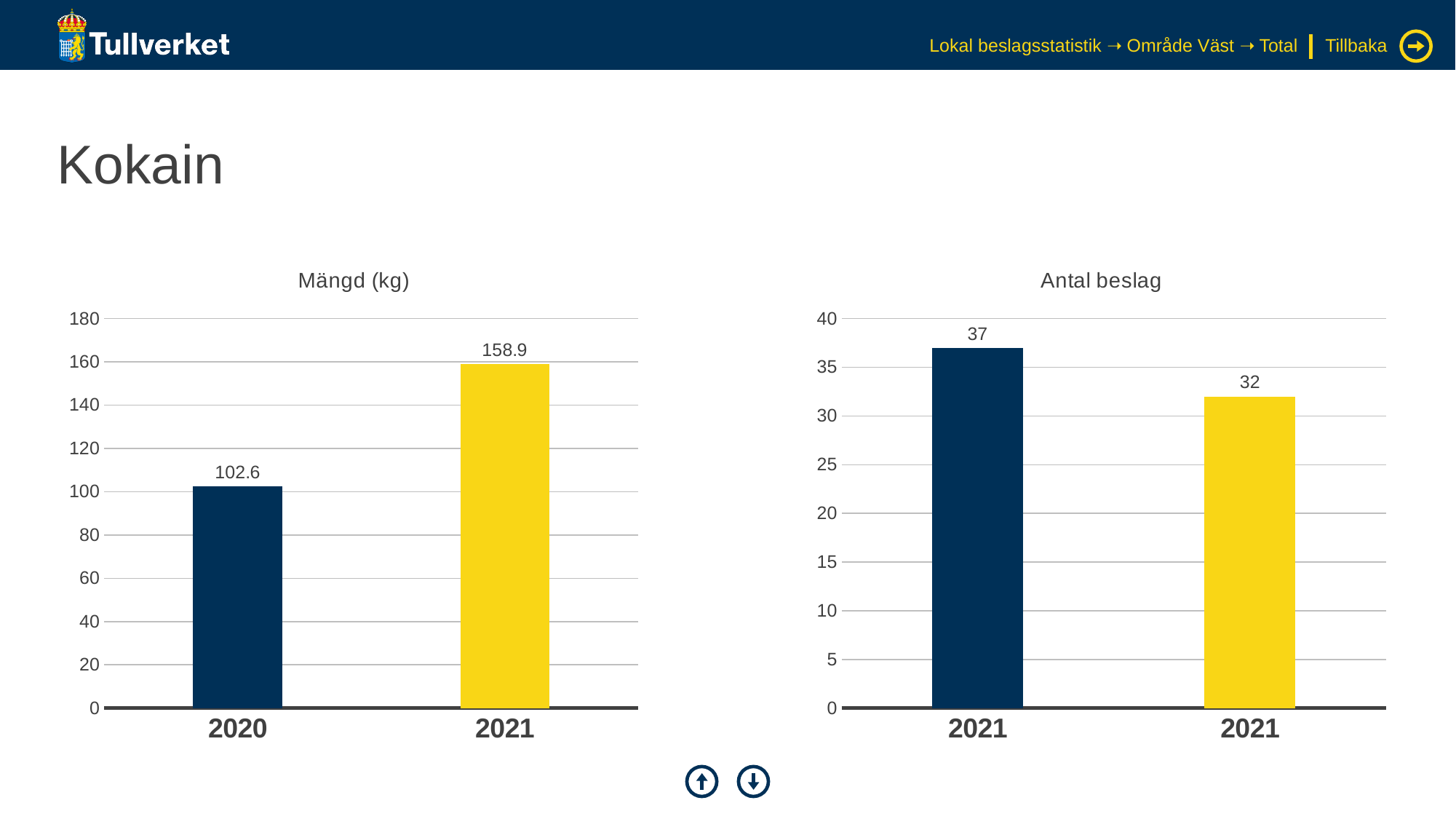
In the "Mängd (kg)" chart, is the value for 2020 greater or less than 100? greater In the "Antal beslag" chart, what is the value of the left (dark blue) bar? 37 How many bars does the "Mängd (kg)" chart show? 2 In the "Antal beslag" chart, what is the difference between the left bar and the right bar? 5 In the "Mängd (kg)" chart, what is the value for 2020? 102.6 What kind of chart is the "Antal beslag" chart? bar chart In the "Mängd (kg)" chart, do the values rise or fall from 2020 to 2021? rise In the "Antal beslag" chart, which bar is larger, the left (dark blue) bar or the right (yellow) bar? the left (dark blue) bar In the "Mängd (kg)" chart, what is the difference between the 2021 and 2020 values? 56.3 In the "Antal beslag" chart, what is the value of the right (yellow) bar? 32 In the "Mängd (kg)" chart, which year has the higher value? 2021 In the "Mängd (kg)" chart, what is the value for 2021? 158.9